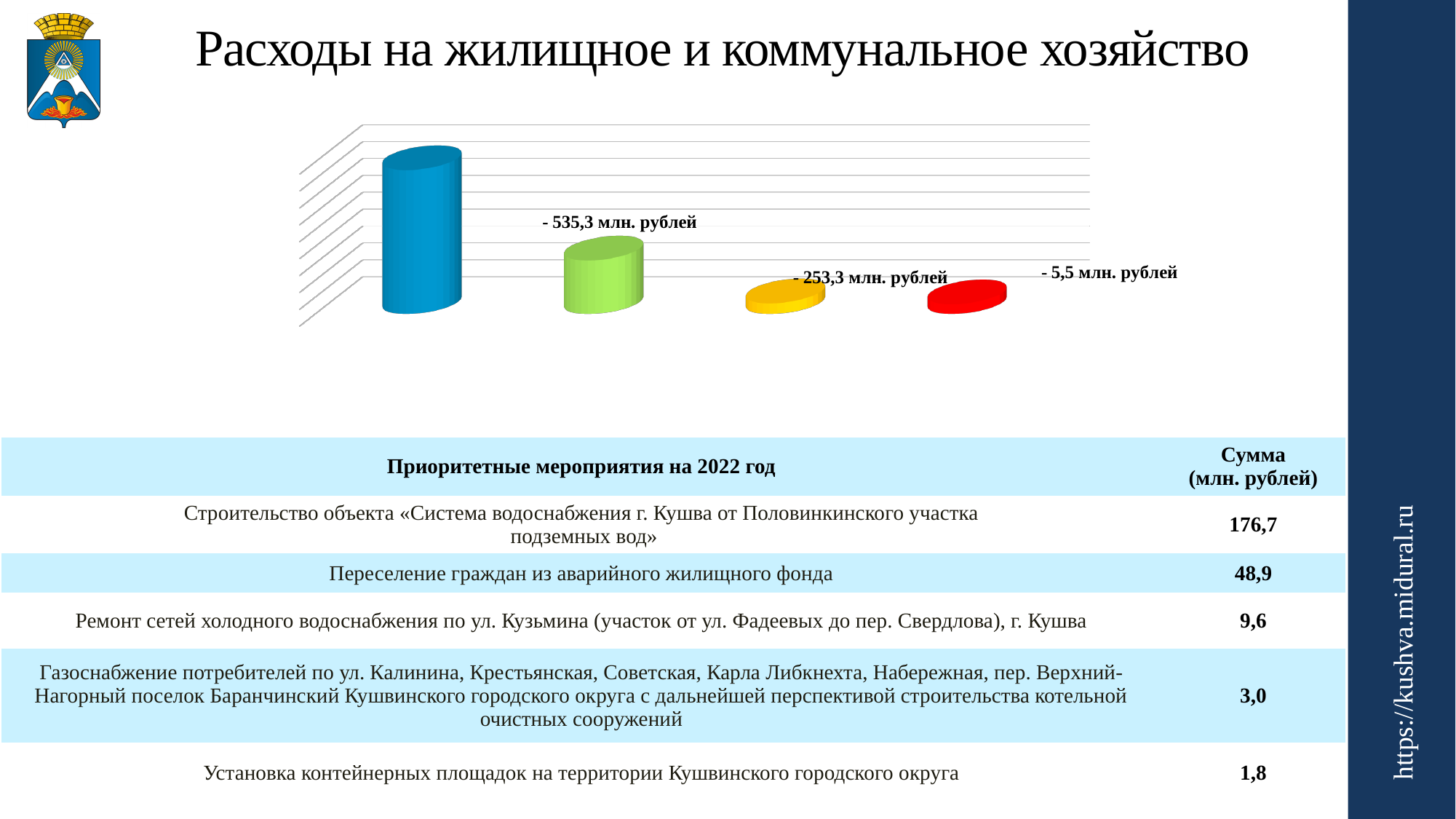
Which is taller in the chart, the green bar or the yellow bar? the green bar How many bars does the chart contain? 4 What kind of chart is shown on the slide? bar chart Does the chart show a legend? No Which bar in the chart is the tallest? the blue bar Which is taller in the chart, the blue bar or the green bar? the blue bar